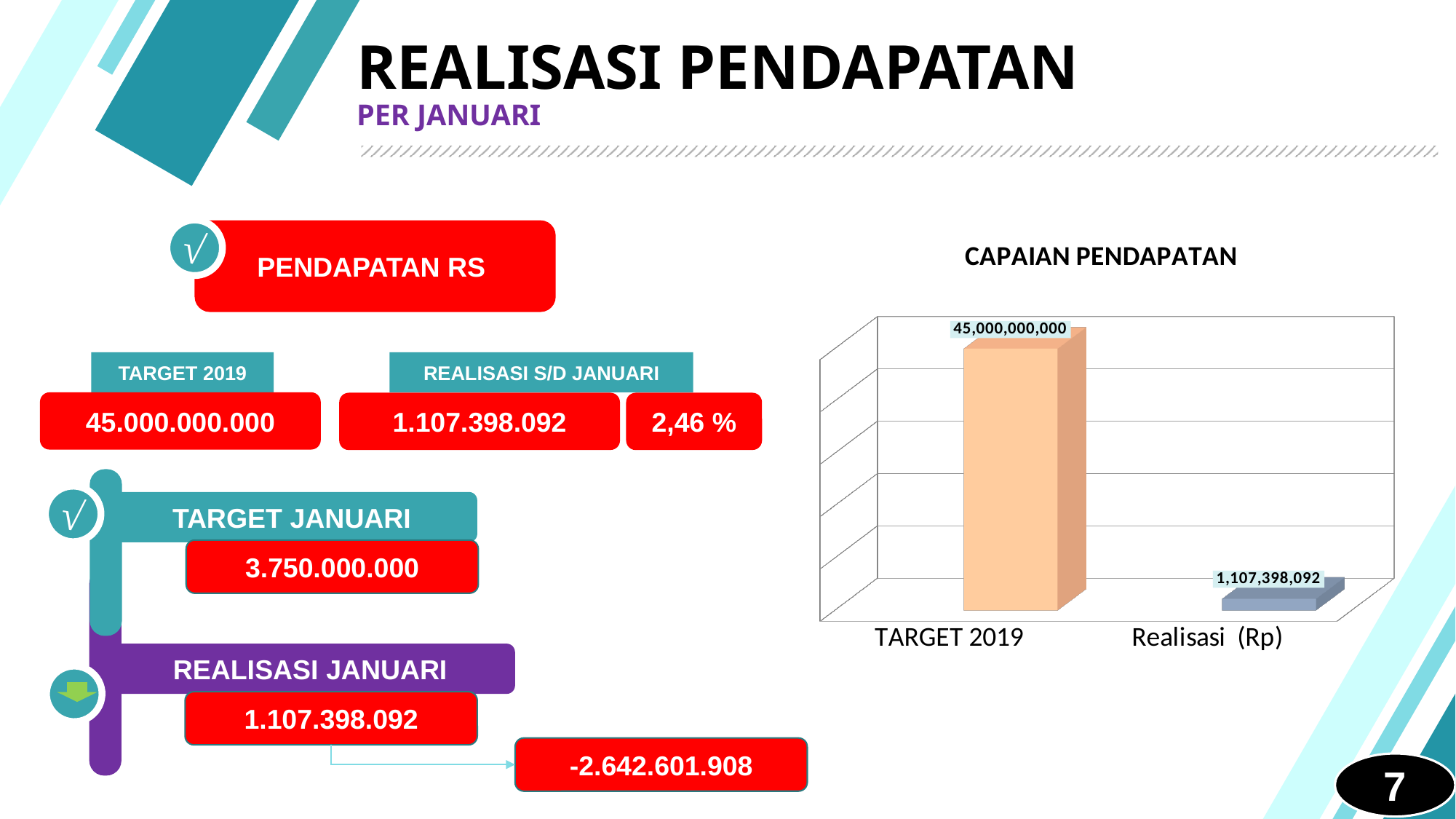
In the CAPAIAN PENDAPATAN chart, what is the difference between the TARGET 2019 value and the Realisasi (Rp) value? 43,892,601,908 Which category has the lowest value in the CAPAIAN PENDAPATAN chart? Realisasi (Rp) What is the value of the Realisasi (Rp) bar in the CAPAIAN PENDAPATAN chart? 1,107,398,092 Which category has the highest value in the CAPAIAN PENDAPATAN chart? TARGET 2019 How many categories are shown in the CAPAIAN PENDAPATAN chart? 2 In the CAPAIAN PENDAPATAN chart, which is larger: TARGET 2019 or Realisasi (Rp)? TARGET 2019 What is the title of the chart on the slide? CAPAIAN PENDAPATAN Do the values in the CAPAIAN PENDAPATAN chart rise or fall from left to right along the x axis? Fall What kind of chart is the CAPAIAN PENDAPATAN chart? Bar chart What colour is the TARGET 2019 bar in the CAPAIAN PENDAPATAN chart? Orange (peach) What is the value of the TARGET 2019 bar in the CAPAIAN PENDAPATAN chart? 45,000,000,000